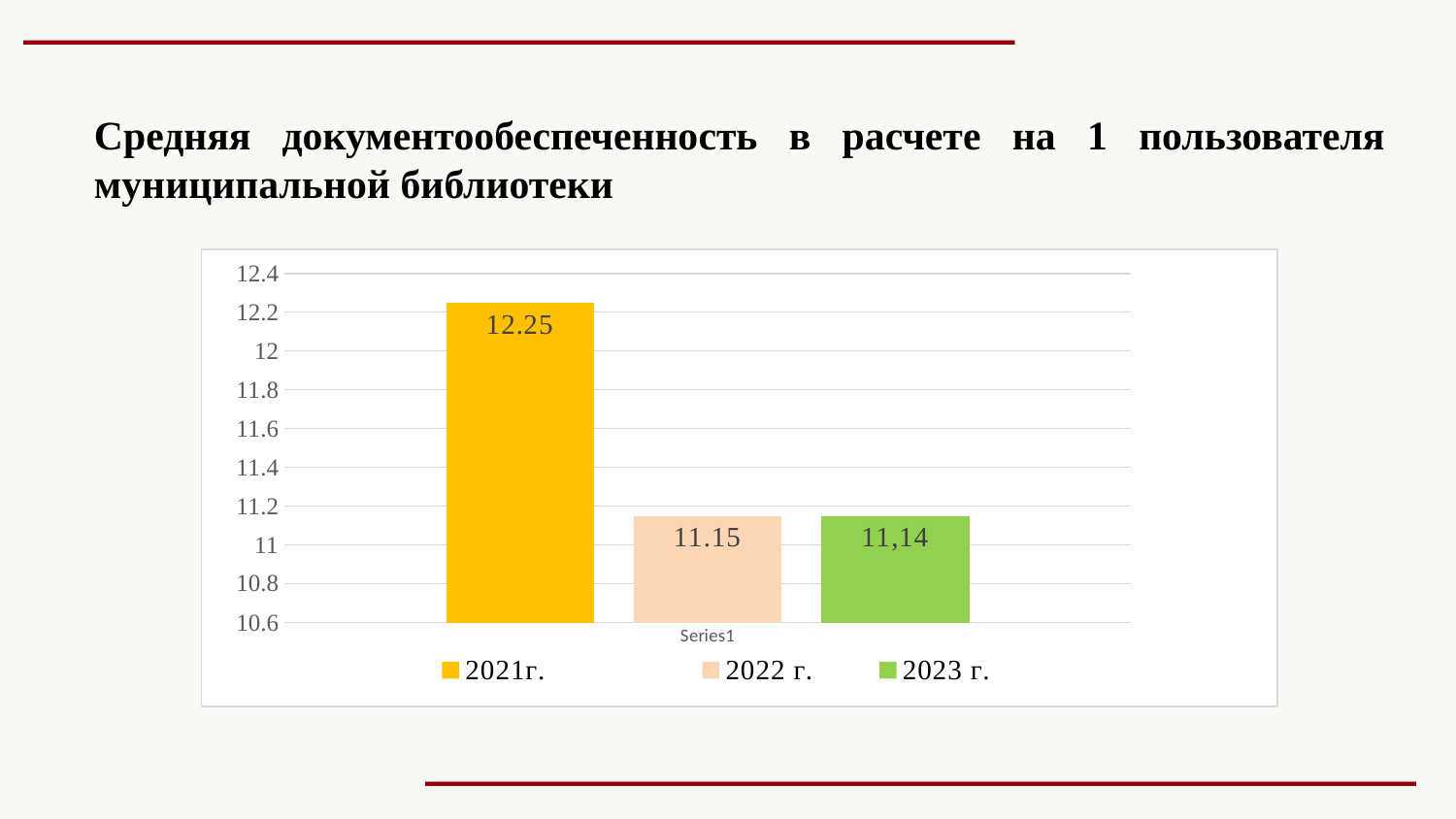
What is the value for 2022 г. in the chart? 11.15 Is the value for 2021г. greater or less than 12? greater What is the difference between the values for 2021г. and 2022 г.? 1.1 What is the difference between the values for 2021г. and 2023 г.? 1.11 What is the value for 2021г. in the chart? 12.25 Which is larger, the value for 2021г. or the value for 2022 г.? 2021г. How many series does the legend list? 3 What is the value for 2023 г. in the chart? 11,14 Which year has the highest value in the chart? 2021г. What colour is the bar for 2023 г.? green Is the value for 2023 г. greater or less than 11.2? less What kind of chart is shown on the slide? bar chart